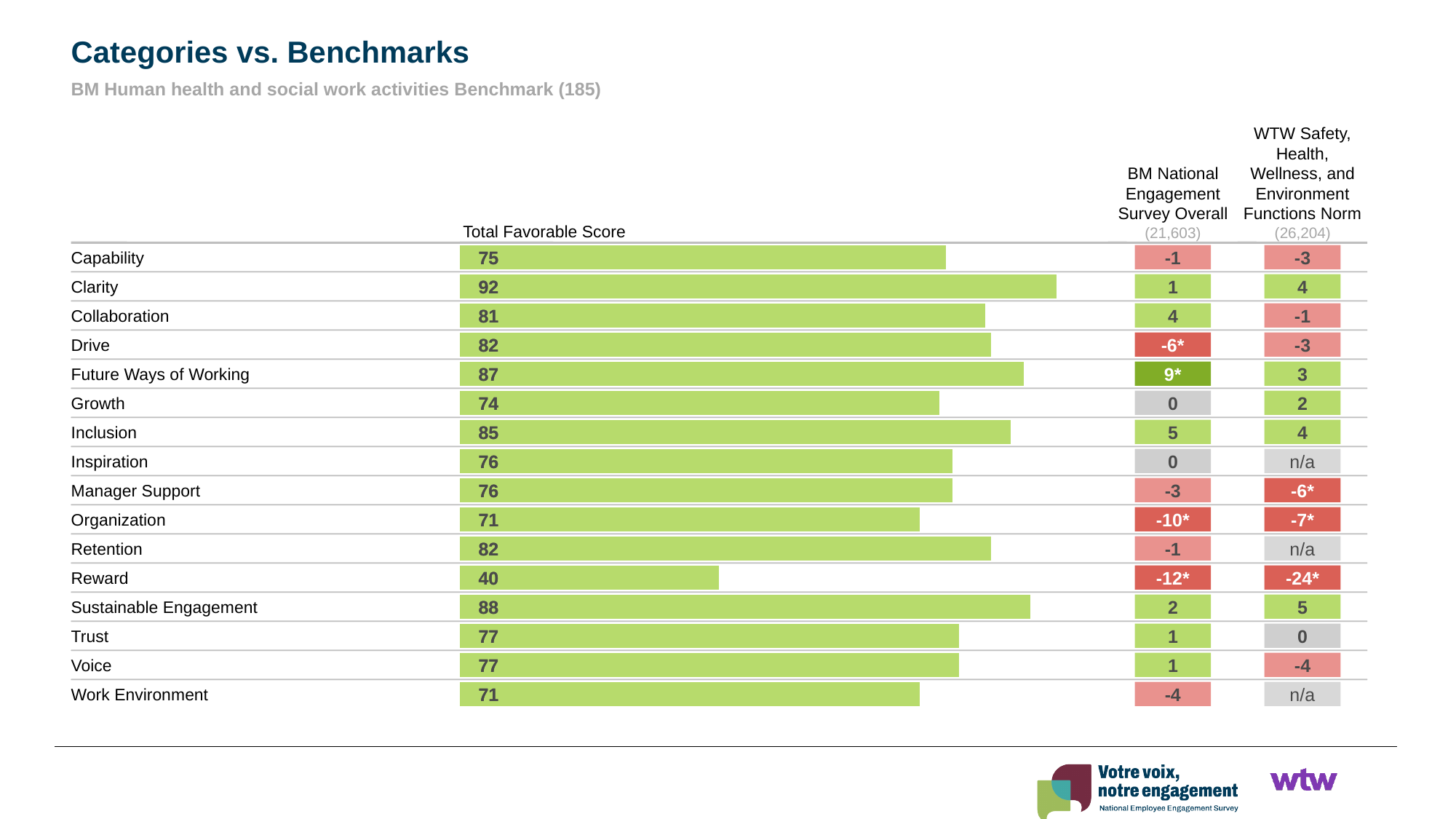
What is the difference versus the WTW Safety, Health, Wellness, and Environment Functions Norm for Reward? -24* What is the title of the slide? Categories vs. Benchmarks Which category has the lowest Total Favorable Score? Reward What is the Total Favorable Score for Clarity? 92 How many categories are shown in the chart? 16 What is the difference between the Total Favorable Scores for Sustainable Engagement and Organization? 17 What is the Total Favorable Score for Work Environment? 71 What is the difference versus the BM National Engagement Survey Overall for Future Ways of Working? 9* Which has a higher Total Favorable Score, Inclusion or Collaboration? Inclusion What is the Total Favorable Score for Reward? 40 Which category has the highest Total Favorable Score? Clarity What kind of chart is used to show the Total Favorable Scores? Bar chart